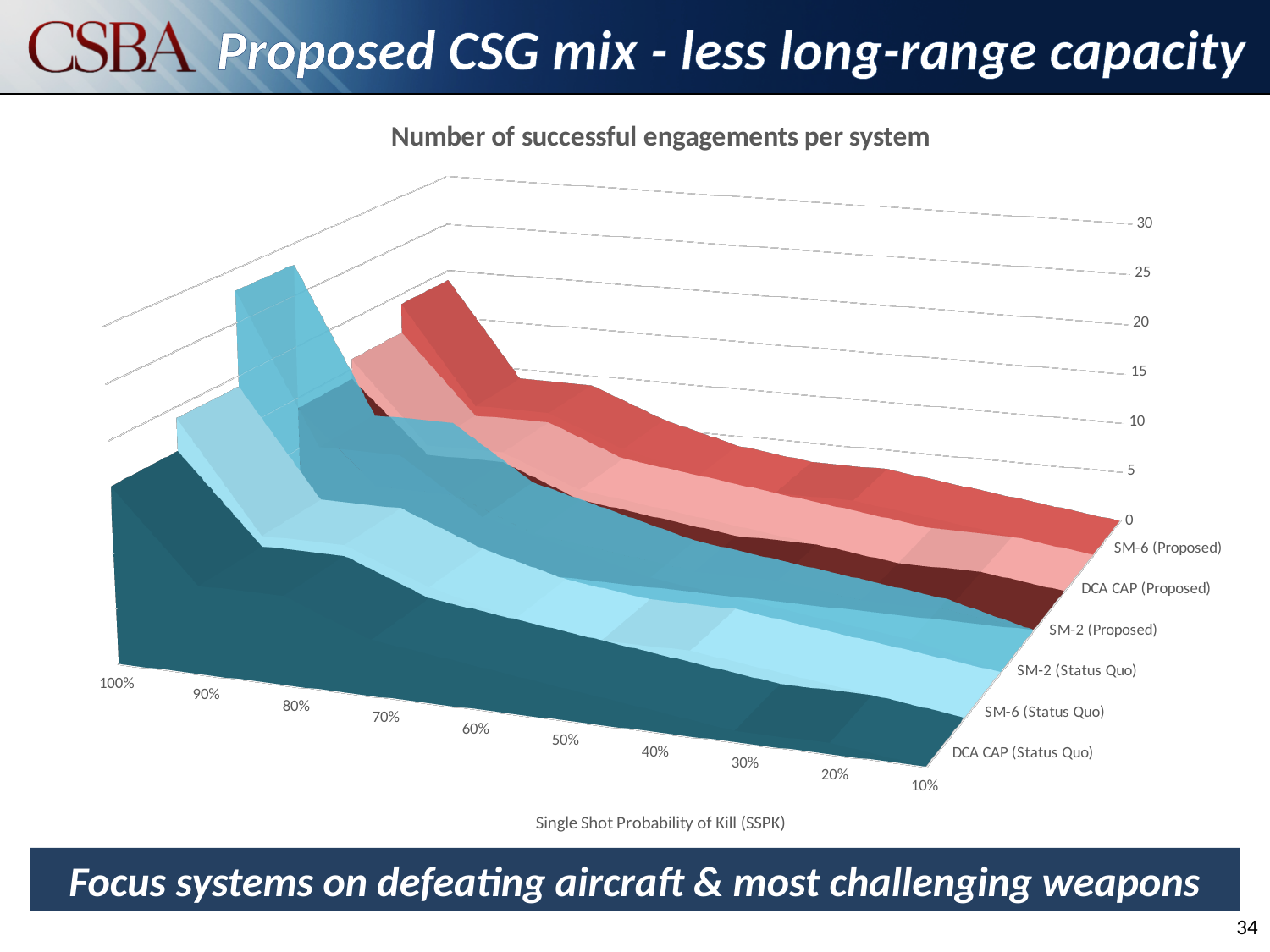
What is the highest value shown on the vertical axis? 30 What kind of chart is shown on the slide? 3D area chart What is the title of the chart? Number of successful engagements per system What is the label of the x axis? Single Shot Probability of Kill (SSPK) Do the number of successful engagements generally rise or fall as SSPK moves from 100% to 10% along the x axis? fall How many Single Shot Probability of Kill (SSPK) categories are shown along the x axis? 10 How many series (systems) are listed along the depth axis of the chart? 6 What is the lowest SSPK value shown on the x axis? 10%